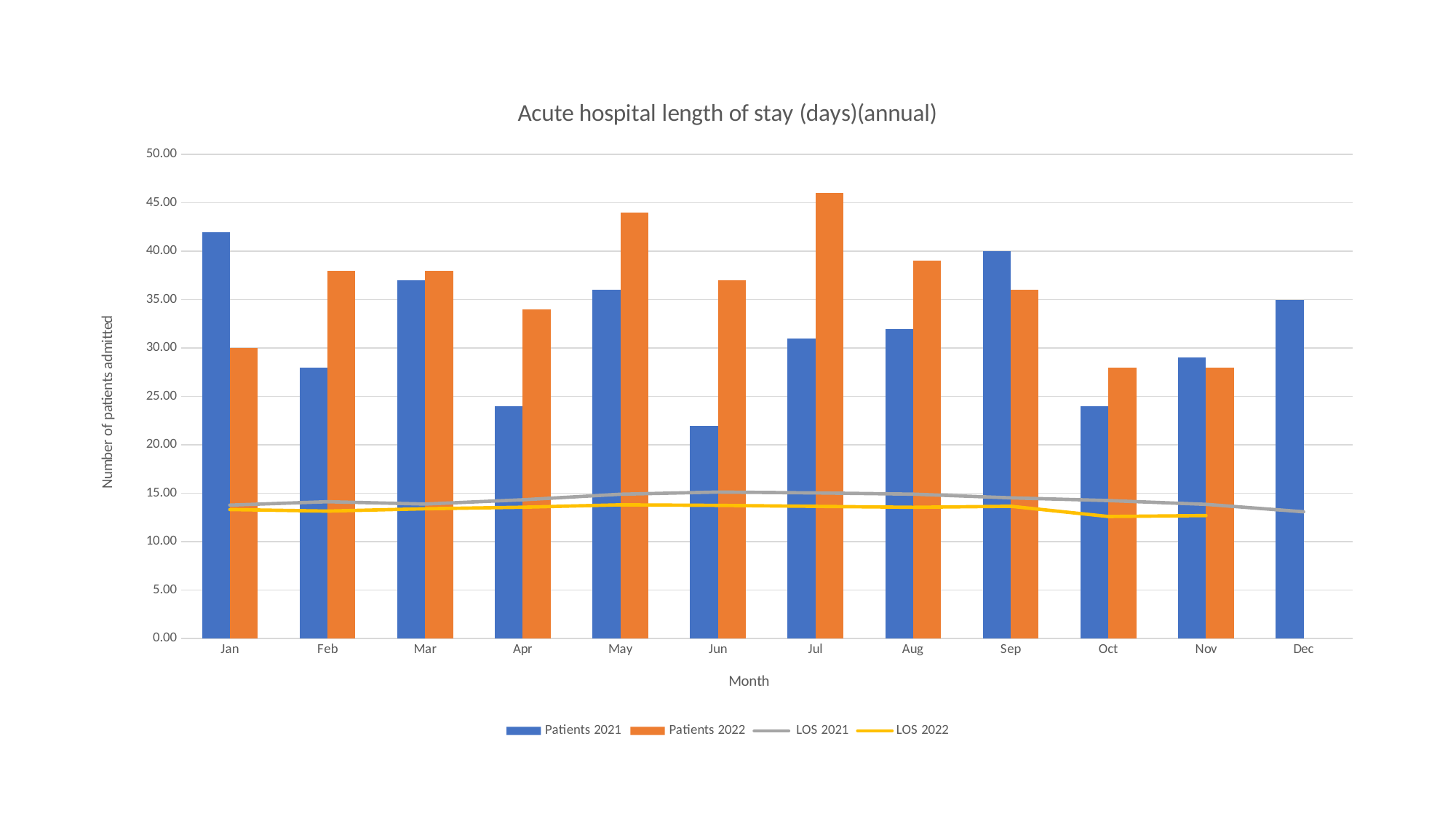
Is the value for Patients 2021 in Jun greater or less than 25.00? less In which month is the Patients 2021 bar lowest? Jun Is the value for Patients 2022 in May greater or less than 40.00? greater How many months are shown on the x axis? 12 In which month is the Patients 2021 bar highest? Jan What is the title of the chart? Acute hospital length of stay (days)(annual) Is the value for Patients 2022 in Jul greater or less than 45.00? greater Does the LOS 2022 line rise or fall from Sep to Oct? Fall In which month is the Patients 2022 bar highest? Jul How many series does the legend list? 4 Which is larger in Jan, Patients 2021 or Patients 2022? Patients 2021 What kind of chart is shown on the slide? A combined bar and line chart